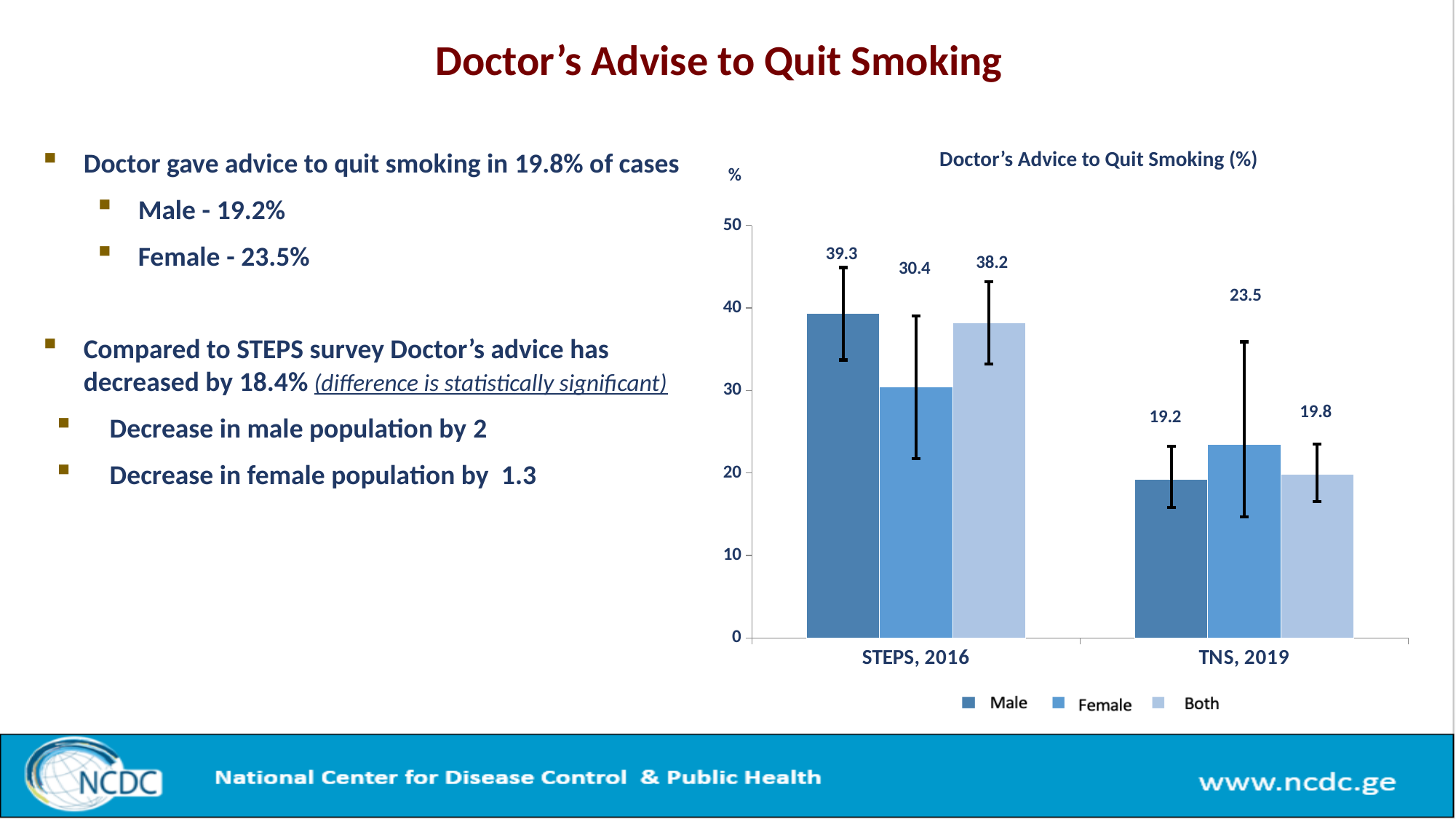
Which is larger: the Female value in STEPS, 2016 or the Female value in TNS, 2019? STEPS, 2016 How many survey categories are shown on the x axis? 2 How many series does the legend list? 3 What is the title of the chart? Doctor's Advice to Quit Smoking (%) Is the value for Both in TNS, 2019 greater or less than 30? less Which series has the highest value in STEPS, 2016? Male What is the value for Male in STEPS, 2016? 39.3 Which series has the lowest value in TNS, 2019? Male What is the value for Female in TNS, 2019? 23.5 What is the difference between the Male values for STEPS, 2016 and TNS, 2019? 20.1 What is the value for Both in STEPS, 2016? 38.2 What kind of chart is shown on the slide? bar chart